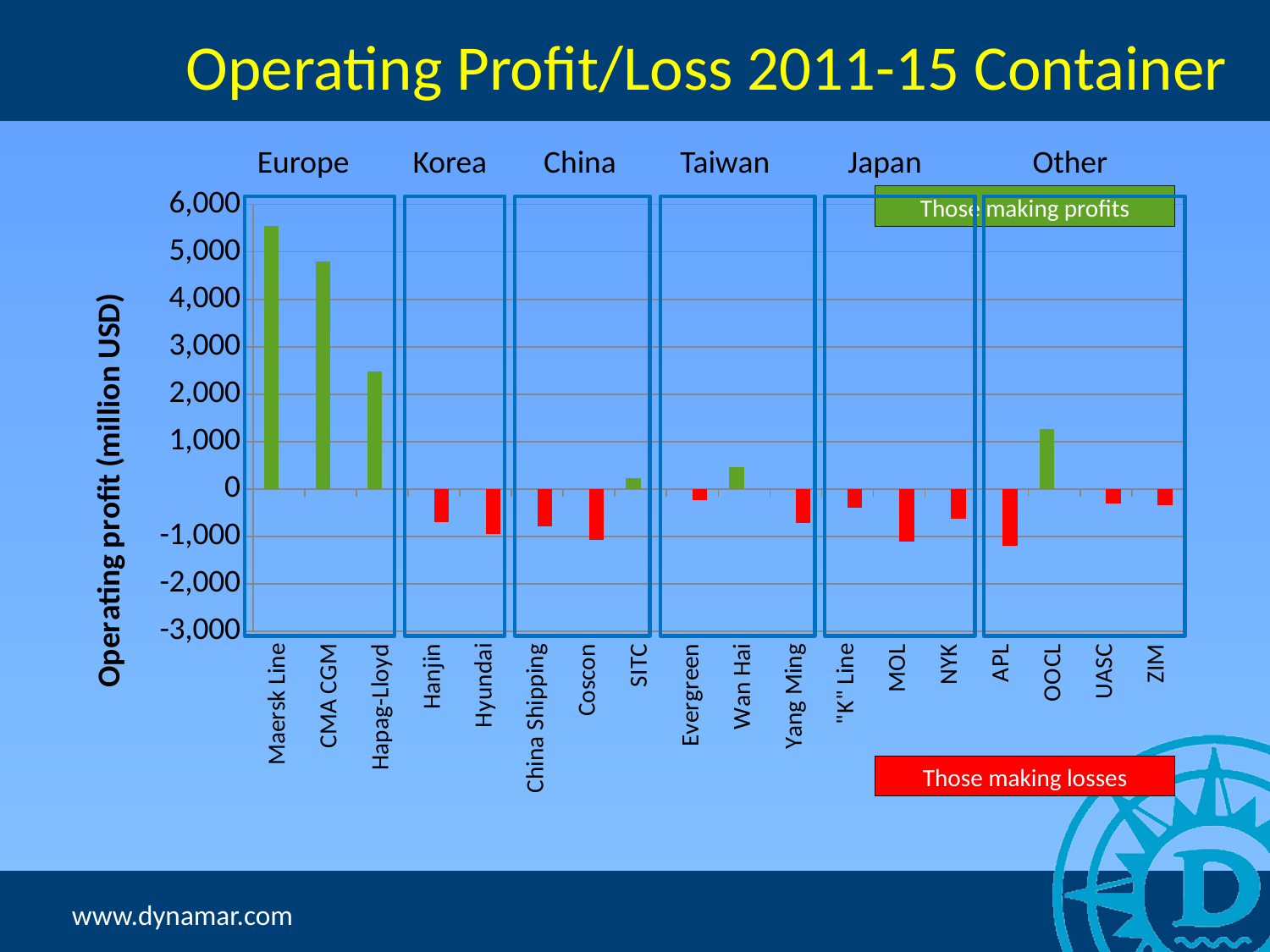
Which has the larger operating profit, Hapag-Lloyd or OOCL? Hapag-Lloyd How many shipping lines (categories) are plotted on the x axis? 18 Is the value for OOCL greater or less than 1,000? greater Which has the larger operating profit, Maersk Line or CMA CGM? Maersk Line Which shipping line has the highest operating profit? Maersk Line Is the value for Maersk Line greater or less than 5,000? greater Is the value for Wan Hai greater or less than 1,000? less What kind of chart is shown on the slide? bar chart What does the green colour of a bar indicate, according to the legend box? Those making profits